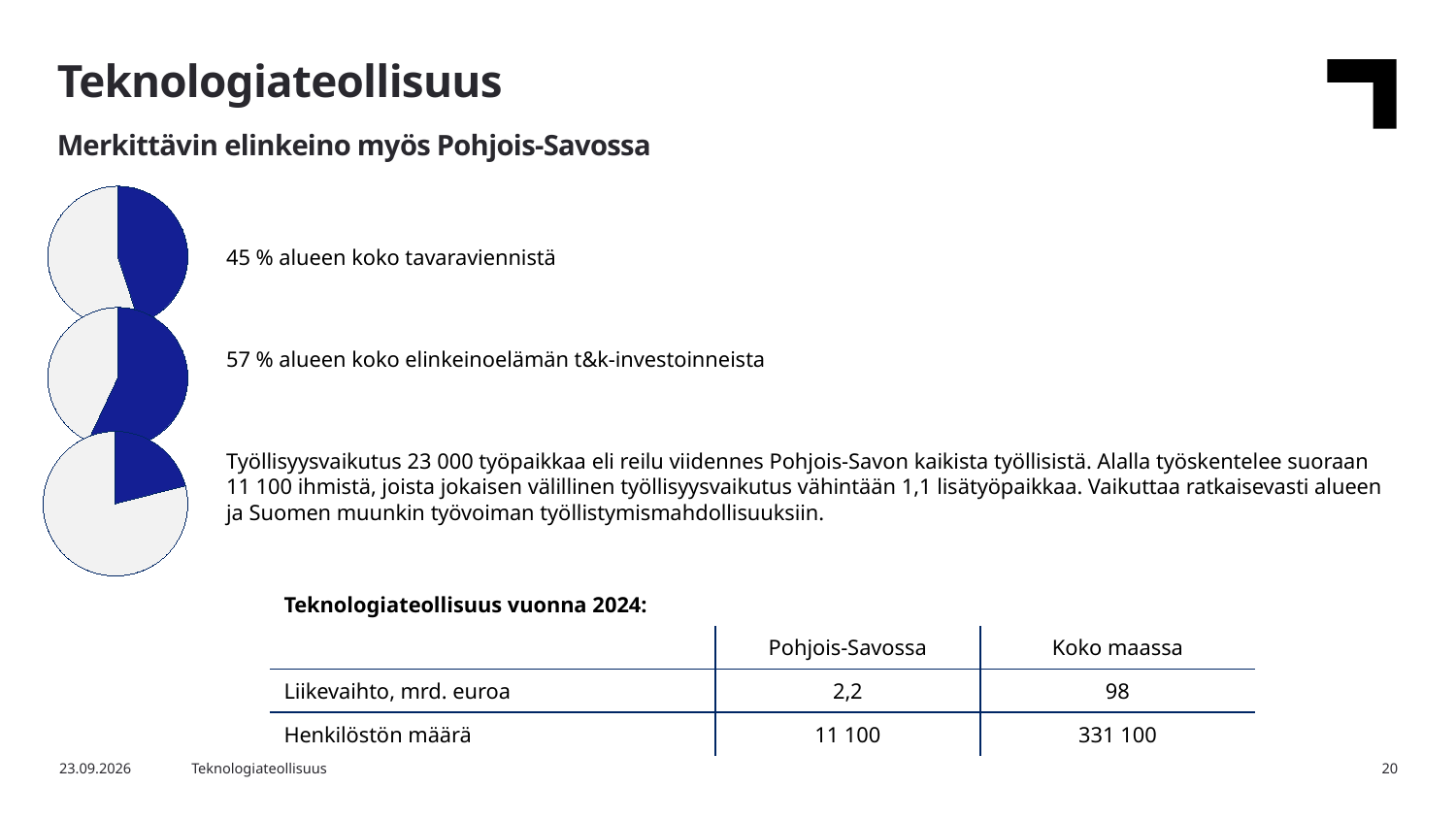
Which pie chart has the smallest blue slice: the top, middle or bottom one? Bottom In the top pie chart, what share of the region's total goods exports does the blue slice represent? 45 % Is the blue share in the bottom pie chart greater or less than 50%? less What colour is used for the highlighted slice in each pie chart? Blue Is the blue share in the middle pie chart greater or less than 50%? greater In the middle pie chart, what share of the region's business R&D investments does the blue slice represent? 57 % Is the blue slice in the middle pie chart larger or smaller than the blue slice in the top pie chart? Larger Which pie chart has the largest blue slice: the top, middle or bottom one? Middle What is the difference in percentage points between the blue shares of the middle pie chart (57 %) and the top pie chart (45 %)? 12 percentage points What is the main title of the slide containing the pie charts? Teknologiateollisuus How many pie charts are on the slide? 3 What kind of charts are shown on the left side of the slide? Pie charts